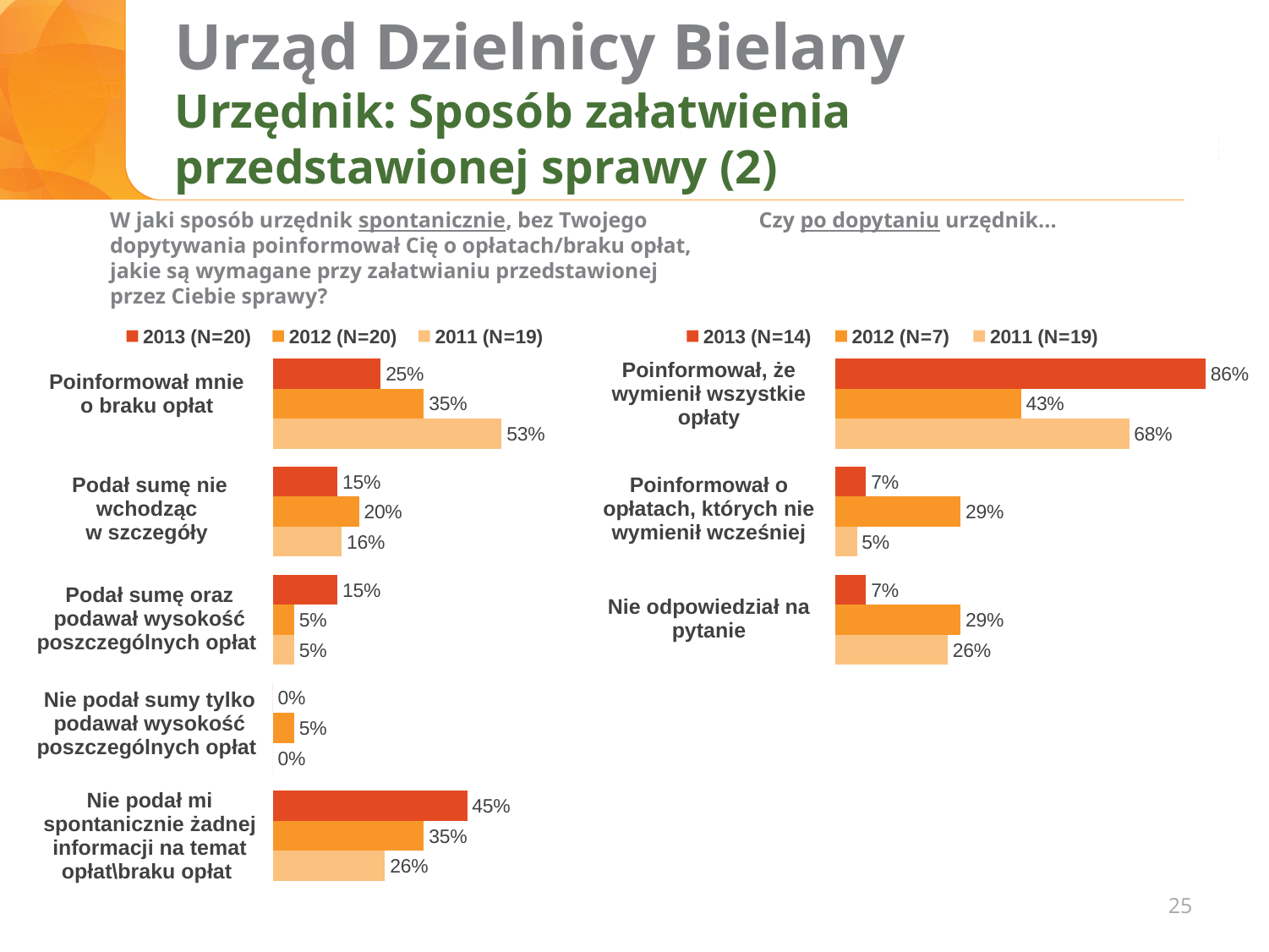
How many categories does the left chart (spontaneous information about fees) show? 5 In the left chart (spontaneous information about fees), which category has the highest 2013 value? Nie podał mi spontanicznie żadnej informacji na temat opłat\braku opłat In the right chart ("Czy po dopytaniu urzędnik..."), which is larger for "Poinformował, że wymienił wszystkie opłaty": the 2012 value or the 2011 value? 2011 (68%) In the left chart (spontaneous information about fees), what is the 2013 value for "Poinformował mnie o braku opłat"? 25% In the right chart ("Czy po dopytaniu urzędnik..."), which category has the lowest 2011 value? Poinformował o opłatach, których nie wymienił wcześniej In the left chart (spontaneous information about fees), what is the difference between the 2011 and 2013 values for "Poinformował mnie o braku opłat"? 28% What type of chart is the left chart (spontaneous information about fees)? Bar chart In the right chart ("Czy po dopytaniu urzędnik..."), what is the 2013 value for "Poinformował, że wymienił wszystkie opłaty"? 86% What sample size (N) is given for 2012 in the legend of the right chart ("Czy po dopytaniu urzędnik...")? N=7 In the left chart (spontaneous information about fees), what is the 2011 value for "Nie podał mi spontanicznie żadnej informacji na temat opłat\braku opłat"? 26% In the right chart ("Czy po dopytaniu urzędnik..."), what is the 2012 value for "Nie odpowiedział na pytanie"? 29% How many series does the legend of the right chart ("Czy po dopytaniu urzędnik...") list? 3